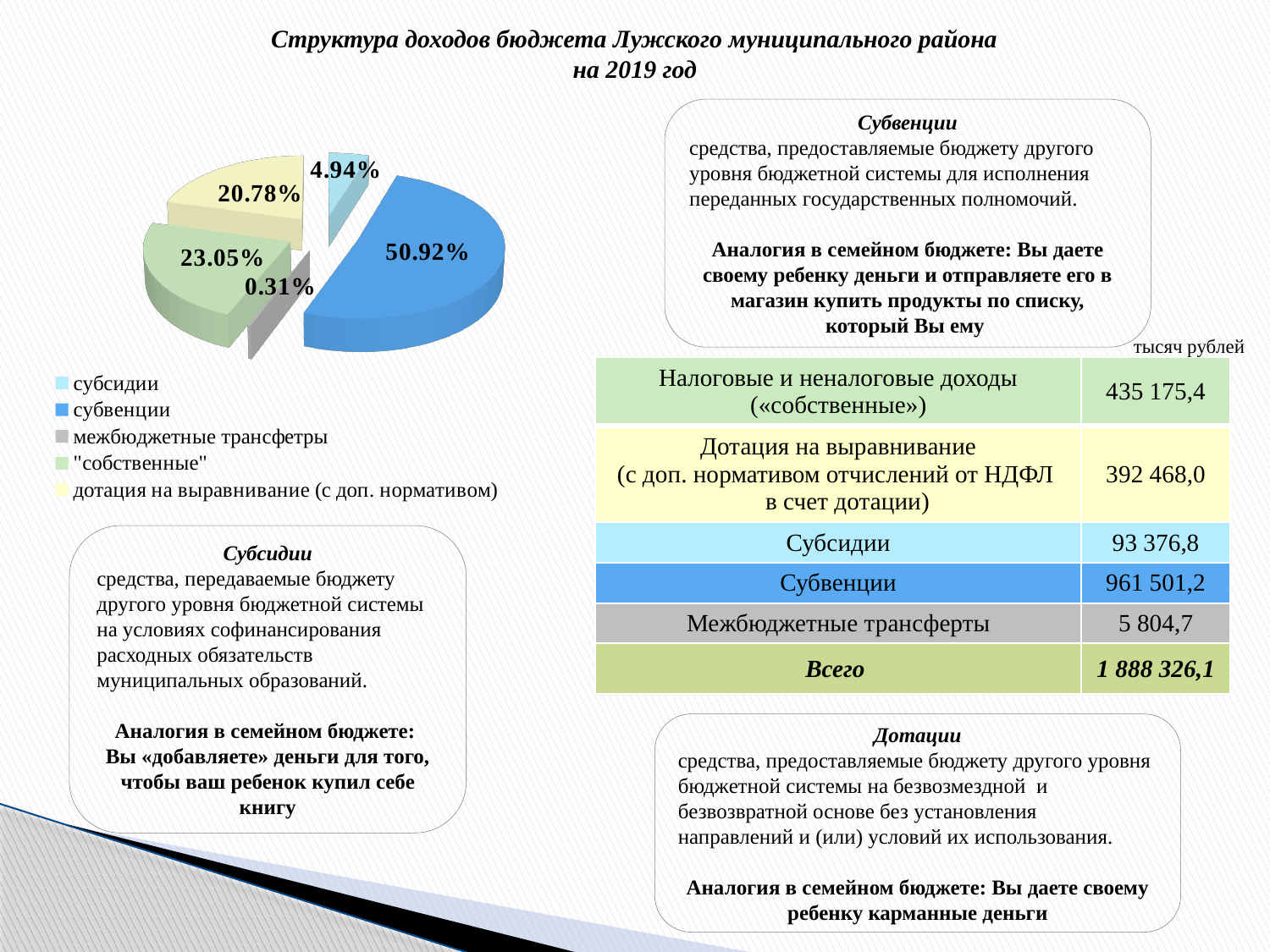
Which category has the largest slice in the pie chart? субвенции How many slices does the pie chart have? 5 What kind of chart is shown on the slide? Pie chart What colour is the субвенции slice in the pie chart? Blue What is the difference in percentage points between the субвенции slice and the "собственные" slice? 27.87 Which category has the smallest slice in the pie chart? межбюджетные трансферты Which slice is larger: "собственные" or дотация на выравнивание (с доп. нормативом)? "собственные" What share of the pie chart does субсидии have? 4.94% What share of the pie chart does субвенции have? 50.92% What share of the pie chart does межбюджетные трансферты have? 0.31% What share of the pie chart does "собственные" have? 23.05% What share of the pie chart does дотация на выравнивание (с доп. нормативом) have? 20.78%